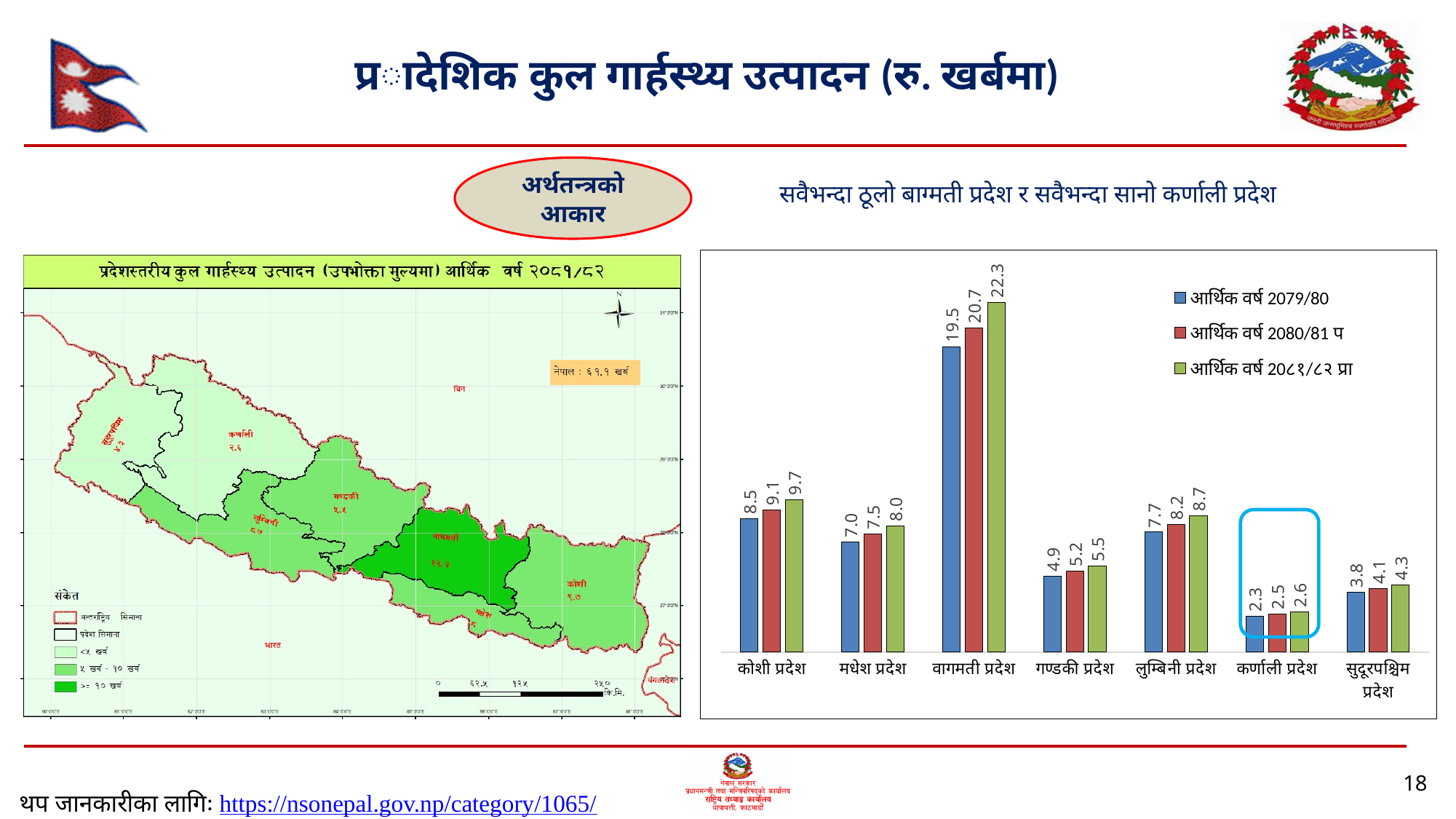
How many series does the legend of the bar chart list? 3 How many provinces are shown on the bar chart? 7 On the bar chart, what is the value for लुम्बिनी प्रदेश in आर्थिक वर्ष 2080/81 प? 8.2 On the bar chart, which province has the lowest value in आर्थिक वर्ष 2079/80? कर्णाली प्रदेश On the bar chart, what is the value for कर्णाली प्रदेश in आर्थिक वर्ष 2079/80? 2.3 On the bar chart, do the values for मधेश प्रदेश rise or fall from आर्थिक वर्ष 2079/80 to आर्थिक वर्ष २०८१/८२ प्रा? Rise On the bar chart, which is larger in आर्थिक वर्ष २०८१/८२ प्रा: गण्डकी प्रदेश or सुदूरपश्चिम प्रदेश? गण्डकी प्रदेश On the bar chart, what is the difference between वागमती प्रदेश and मधेश प्रदेश in आर्थिक वर्ष 2080/81 प? 13.2 On the bar chart, which province has the highest value in आर्थिक वर्ष २०८१/८२ प्रा? वागमती प्रदेश On the bar chart, what is the value for वागमती प्रदेश in आर्थिक वर्ष २०८१/८२ प्रा? 22.3 On the bar chart, what is the difference between the आर्थिक वर्ष २०८१/८२ प्रा value and the आर्थिक वर्ष 2079/80 value for कोशी प्रदेश? 1.2 What kind of chart is shown on the right side of the slide? Bar chart